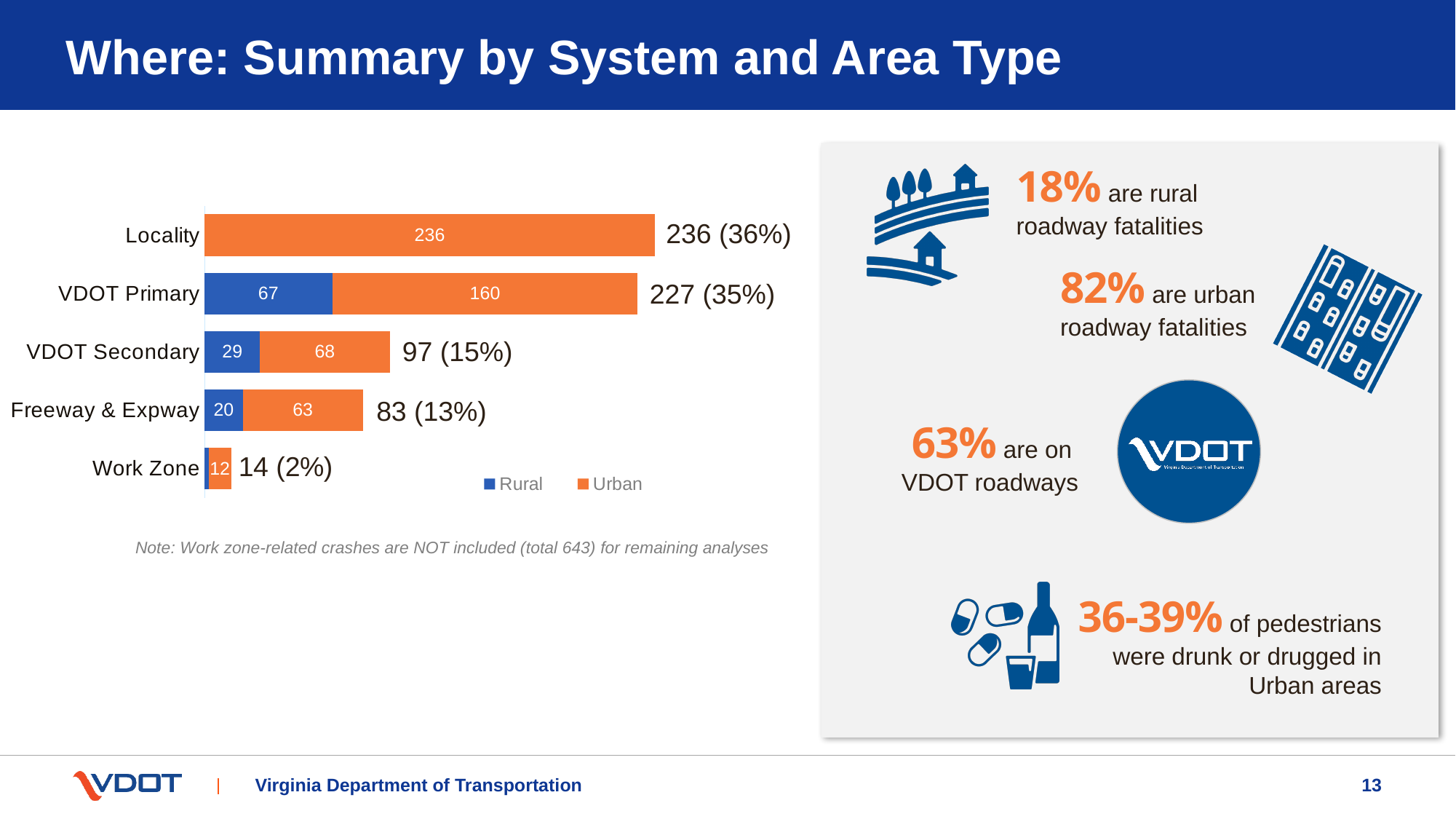
What is the Urban value for VDOT Primary? 160 Which category has the lowest total? Work Zone What is the total shown for the Locality bar? 236 (36%) How many categories are shown on the chart? 5 Which series is shown in orange in the legend? Urban What is the Urban value for Freeway & Expway? 63 How many series does the chart legend list? 2 What type of chart is shown on the slide? Stacked bar chart What is the difference between the Urban and Rural values for VDOT Primary? 93 Which is larger, the Rural value for VDOT Primary or the Rural value for Freeway & Expway? VDOT Primary What is the Rural value for VDOT Secondary? 29 Which category has the highest total? Locality